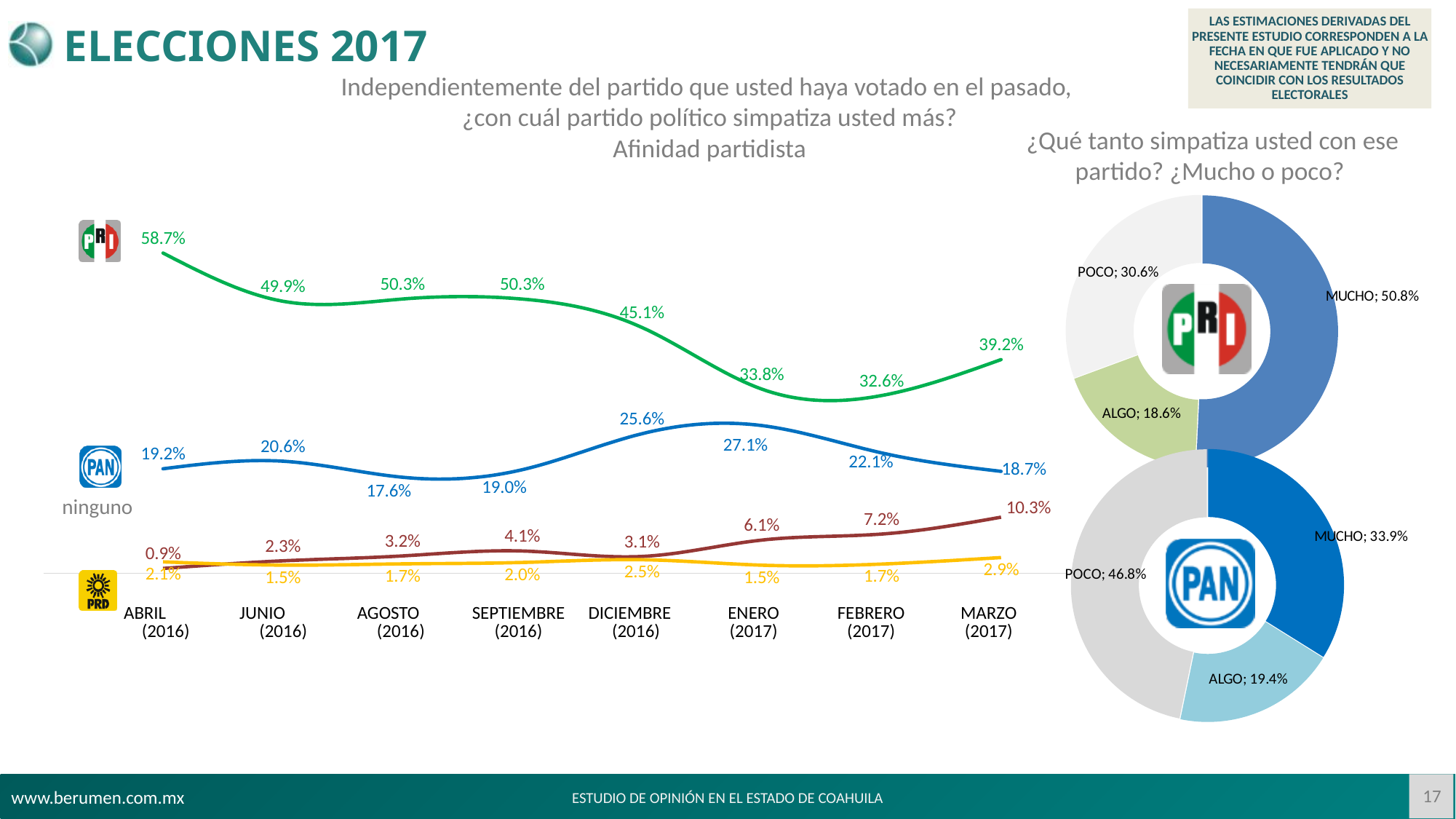
In the line chart 'Afinidad partidista', in which month is the PRI value lowest? FEBRERO (2017) How many time points are plotted along the x axis of the line chart 'Afinidad partidista'? 8 In the line chart 'Afinidad partidista', what is the PRI value for ABRIL (2016)? 58.7% In the line chart 'Afinidad partidista', what is the PAN value for ENERO (2017)? 27.1% In the PRI doughnut chart on the right, what share is MUCHO? 50.8% In the line chart 'Afinidad partidista', does the PRI value rise or fall from ABRIL (2016) to FEBRERO (2017)? Fall In the line chart 'Afinidad partidista', is the PAN value higher in JUNIO (2016) or in MARZO (2017)? JUNIO (2016) In the line chart 'Afinidad partidista', what is the difference between the PRI value in ABRIL (2016) and in MARZO (2017)? 19.5 percentage points In the PAN doughnut chart on the right, which segment is the largest? POCO In the line chart 'Afinidad partidista', in which month is the PRI value highest? ABRIL (2016) In the PAN doughnut chart on the right, what is the value for ALGO? 19.4% What kind of chart is 'Afinidad partidista'? Line chart